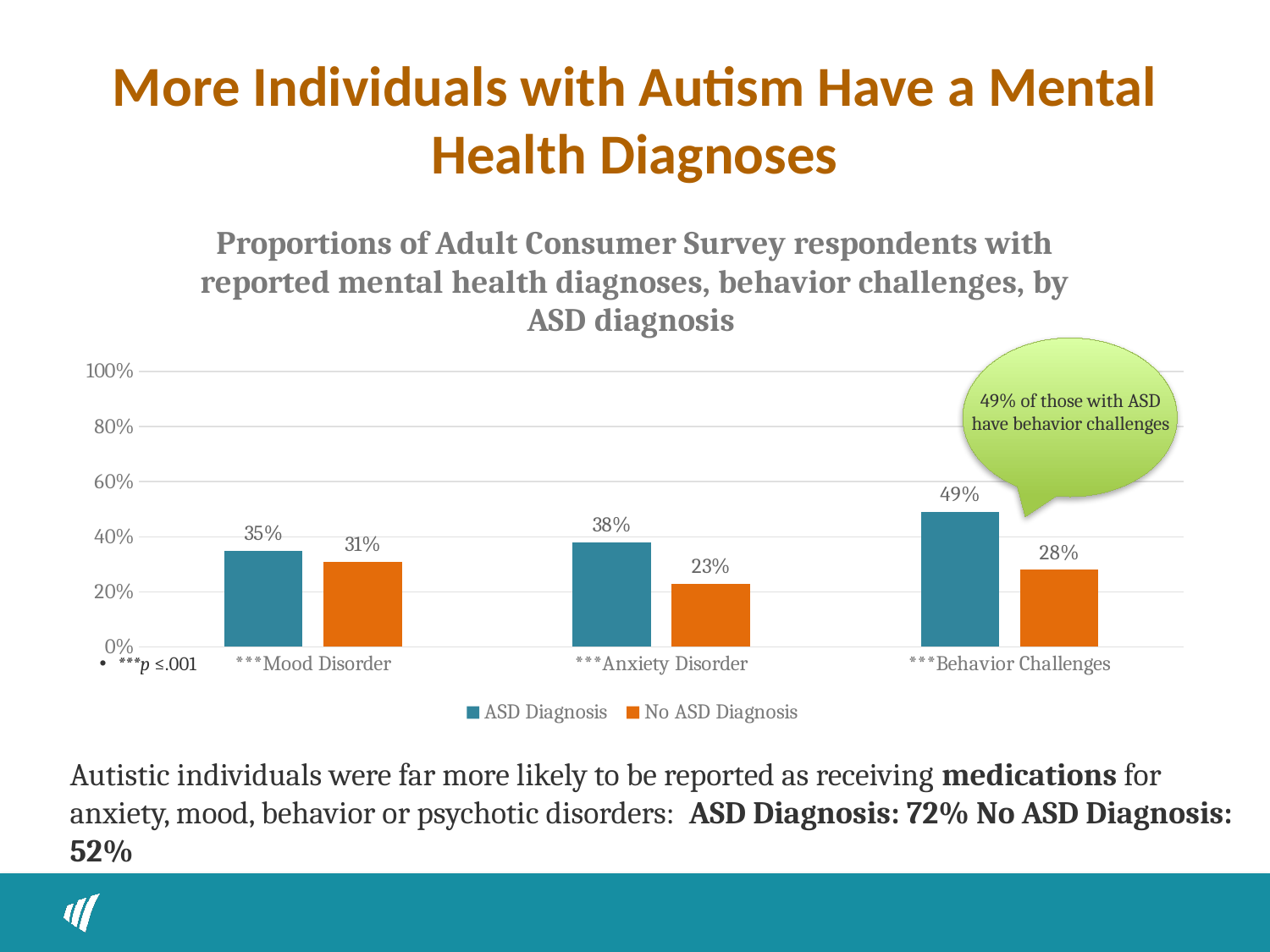
Which category has the lowest value for the No ASD Diagnosis series? Anxiety Disorder What colour are the bars for the No ASD Diagnosis series? Orange What kind of chart is shown on the slide? Bar chart What is the value for ASD Diagnosis in the Mood Disorder category? 35% Is the value for No ASD Diagnosis in the Mood Disorder category greater or less than 40%? less What is the value for ASD Diagnosis in the Behavior Challenges category? 49% How many categories are shown on the x axis? 3 How many series does the legend list? 2 Which is larger in the Anxiety Disorder category: ASD Diagnosis or No ASD Diagnosis? ASD Diagnosis What is the value for No ASD Diagnosis in the Anxiety Disorder category? 23% Which category has the highest value for the ASD Diagnosis series? Behavior Challenges What is the difference between the ASD Diagnosis and No ASD Diagnosis values for Behavior Challenges? 21%